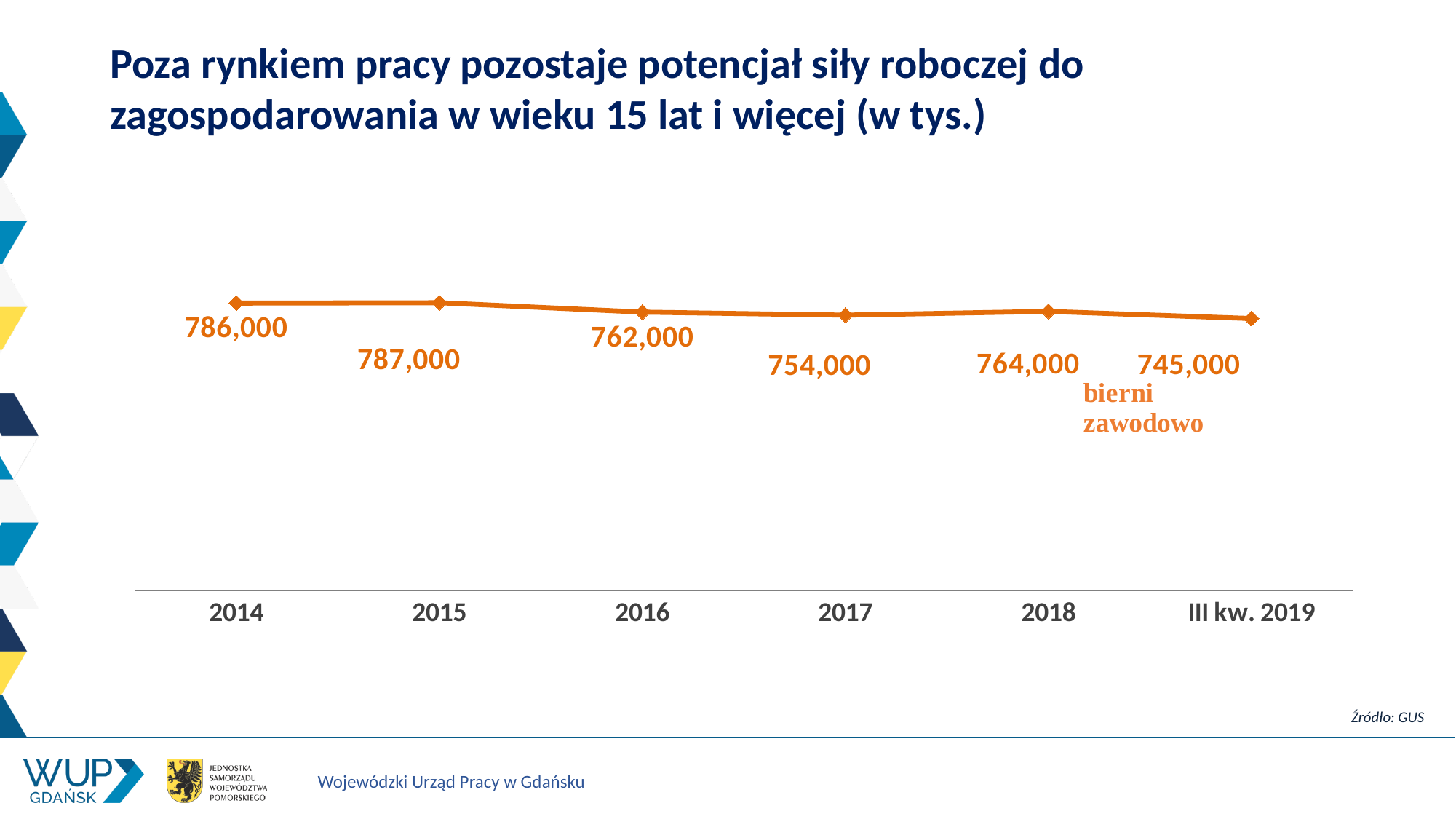
Do the values generally rise or fall from 2014 to III kw. 2019? fall What is the difference between the values for 2014 and 2017? 32,000 What is the value for 2016? 762,000 What is the name of the series labelled on the chart? bierni zawodowo What kind of chart is shown on the slide? line chart Which year has the highest value? 2015 Which is larger, the value for 2017 or the value for 2018? 2018 How many data points are plotted on the chart? 6 What is the value for 2014? 786,000 What is the value for III kw. 2019? 745,000 What is the difference between the values for 2018 and III kw. 2019? 19,000 Which category has the lowest value? III kw. 2019